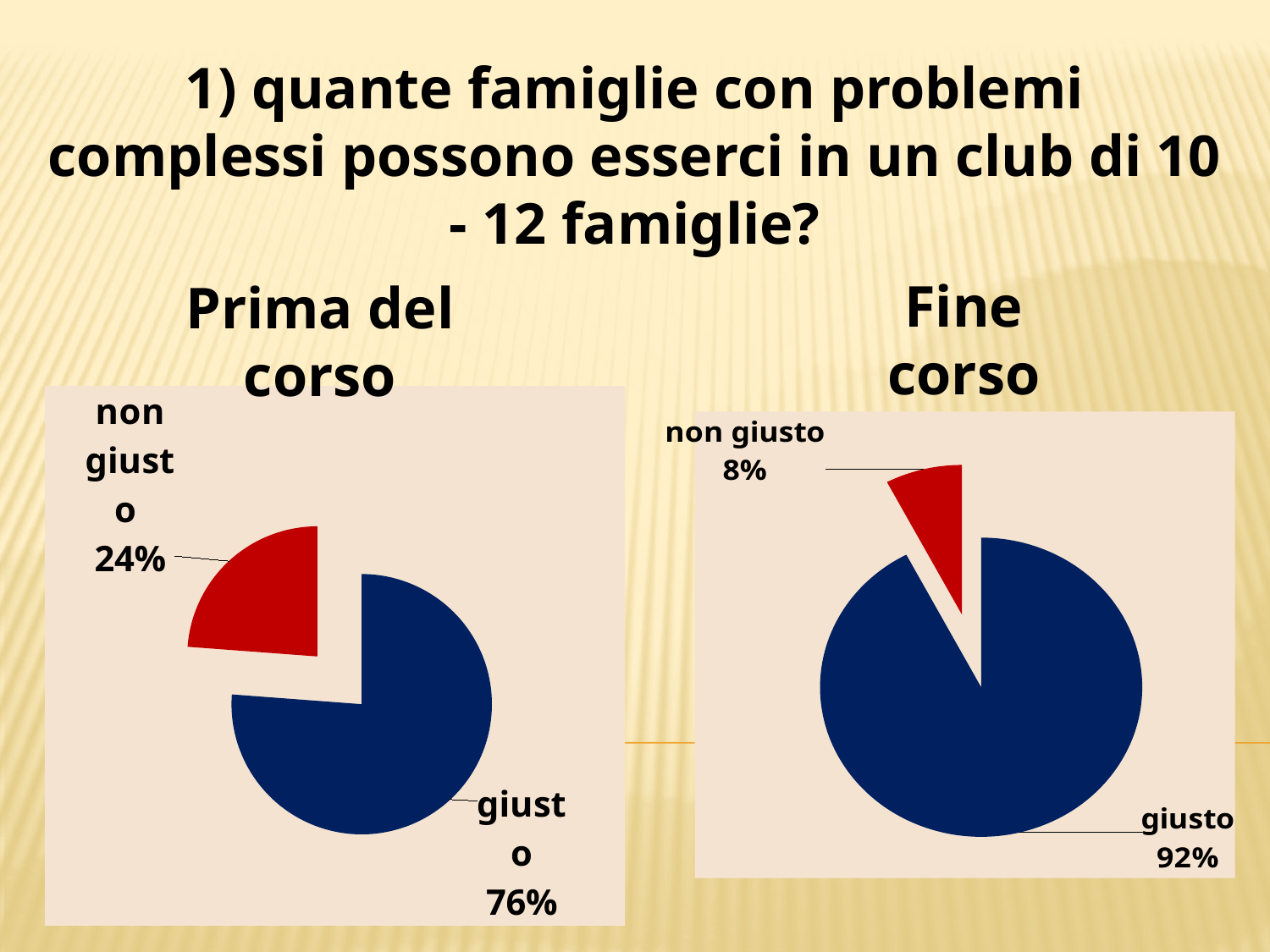
In the 'Prima del corso' pie chart, what share is labelled 'giusto'? 76% In the 'Prima del corso' pie chart, which slice is the largest? giusto In the 'Fine corso' pie chart, what share is labelled 'giusto'? 92% In the 'Fine corso' pie chart, which slice is the smallest? non giusto What type of chart is used on the left ('Prima del corso')? Pie chart What is the title of the pie chart on the right? Fine corso In the 'Fine corso' pie chart, what share is labelled 'non giusto'? 8% Is the 'non giusto' share larger in the 'Prima del corso' chart or in the 'Fine corso' chart? Prima del corso In the 'Prima del corso' pie chart, what colour is the 'non giusto' slice? Red In the 'Prima del corso' pie chart, what share is labelled 'non giusto'? 24% How many slices does the 'Fine corso' pie chart have? 2 What is the difference between the 'giusto' share in the 'Fine corso' chart and the 'giusto' share in the 'Prima del corso' chart? 16%